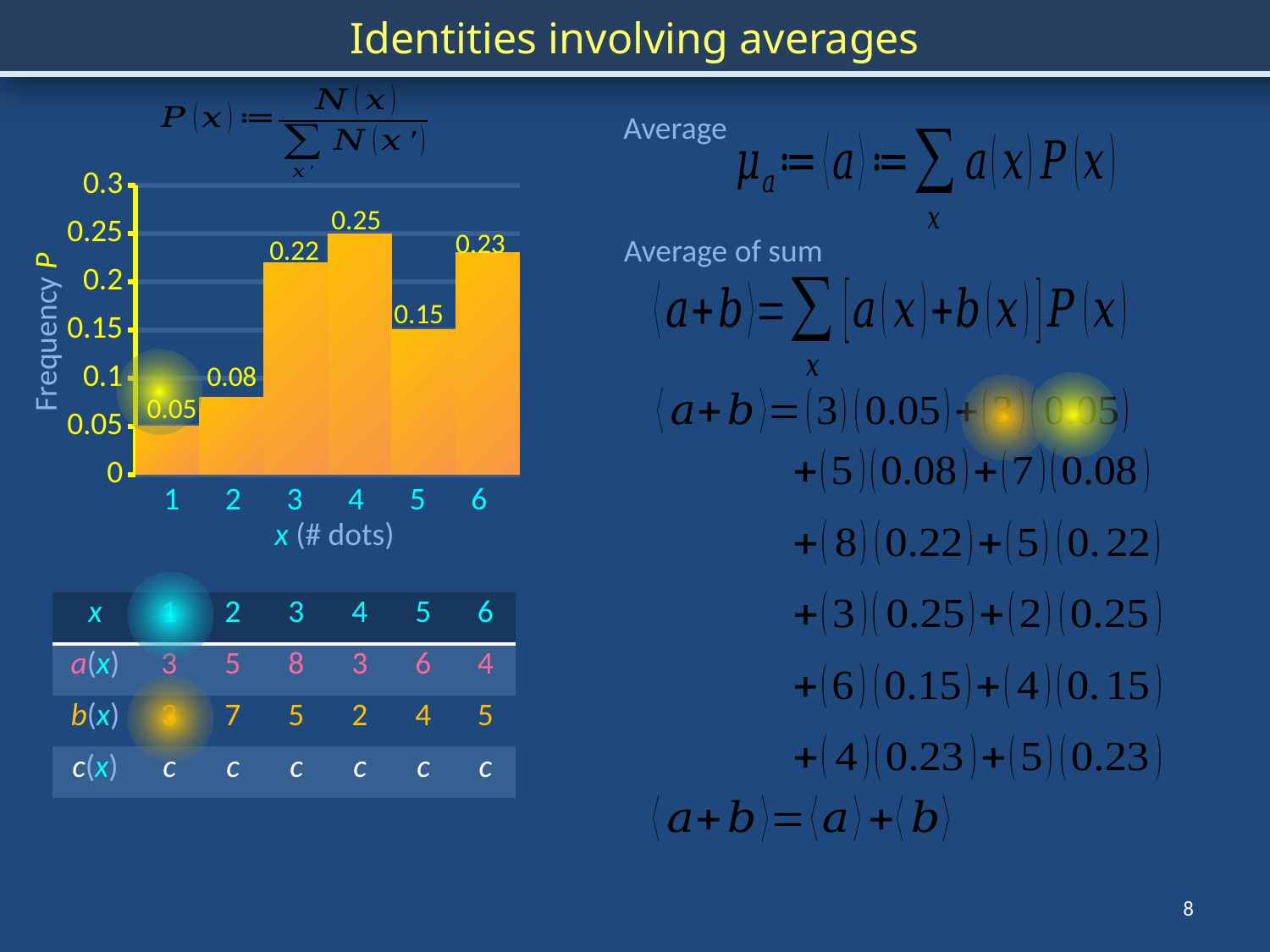
Is the frequency for x = 3 greater or less than 0.2? greater Which value of x has the lowest frequency P? 1 What kind of chart is shown on the slide? bar chart What is the frequency P for x = 5? 0.15 Which value of x has the highest frequency P? 4 Which has a larger frequency P, x = 6 or x = 5? x = 6 What is the label of the vertical axis of the chart? Frequency P What is the frequency P for x = 1? 0.05 What is the difference between the frequency for x = 3 and the frequency for x = 2? 0.14 What is the label of the horizontal axis of the chart? x (# dots) How many bars are shown in the chart? 6 What is the frequency P for x = 4? 0.25